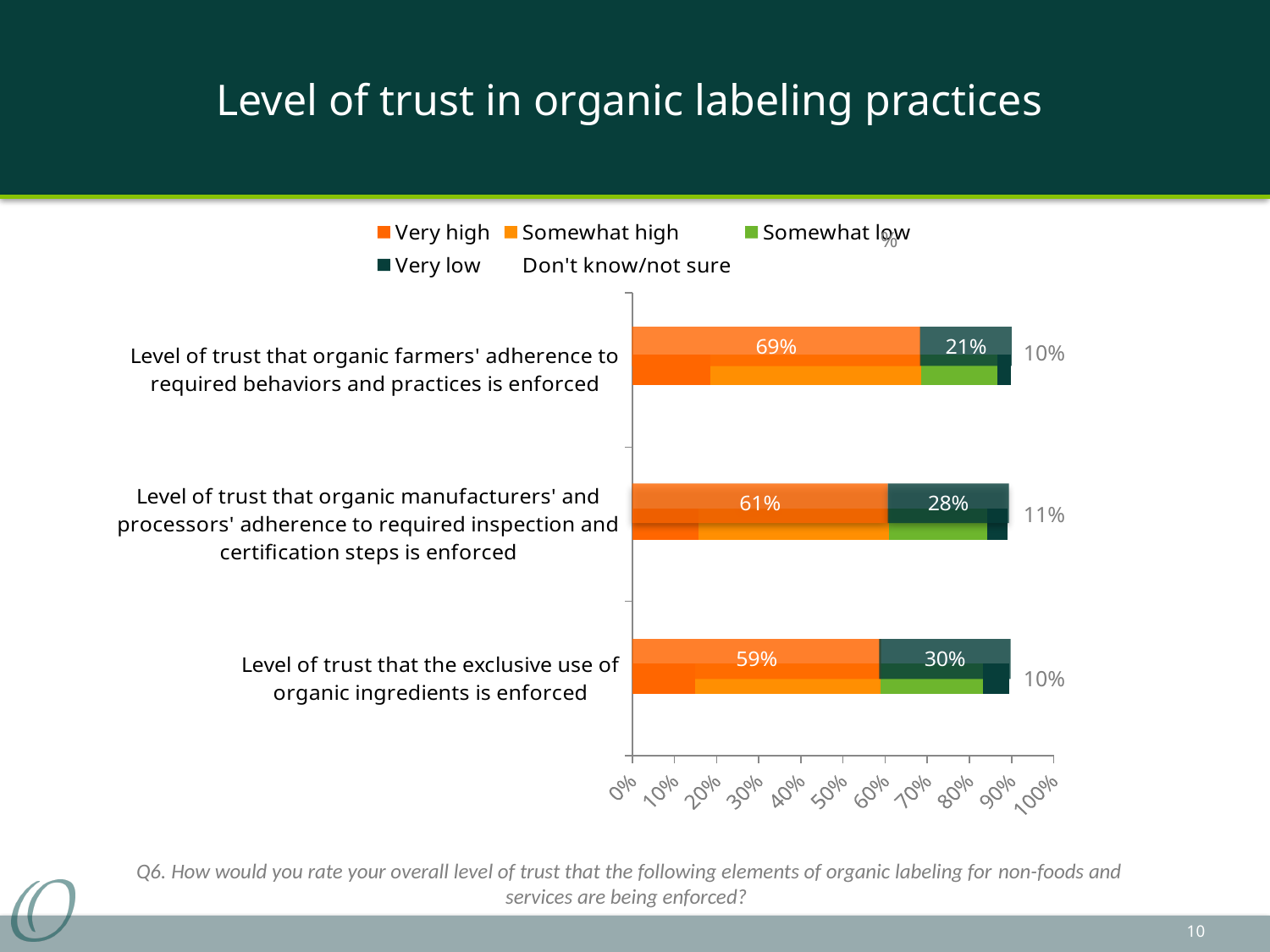
What percentage label is shown over the orange (high trust) portion of the bar for 'Level of trust that organic farmers' adherence to required behaviors and practices is enforced'? 69% How many categories (bars) does the chart show? 3 What is the difference between the high-trust labels for the organic farmers' adherence bar (69%) and the exclusive use of organic ingredients bar (59%)? 10% What is the title of the chart on the slide? Level of trust in organic labeling practices What percentage is shown to the right of the bar for 'Level of trust that organic manufacturers' and processors' adherence to required inspection and certification steps is enforced'? 11% What percentage is shown to the right of the bar for 'Level of trust that the exclusive use of organic ingredients is enforced'? 10% Which category has the lowest percentage label over its orange (high trust) portion? Level of trust that the exclusive use of organic ingredients is enforced Which is larger: the low-trust label for the organic manufacturers' and processors' bar or the low-trust label for the exclusive use of organic ingredients bar? Exclusive use of organic ingredients (30%) What type of chart is shown on the slide? Stacked bar chart How many series does the legend list? 5 Which category has the highest percentage label over its orange (high trust) portion? Level of trust that organic farmers' adherence to required behaviors and practices is enforced What percentage label is shown over the green (low trust) portion of the bar for 'Level of trust that organic manufacturers' and processors' adherence to required inspection and certification steps is enforced'? 28%